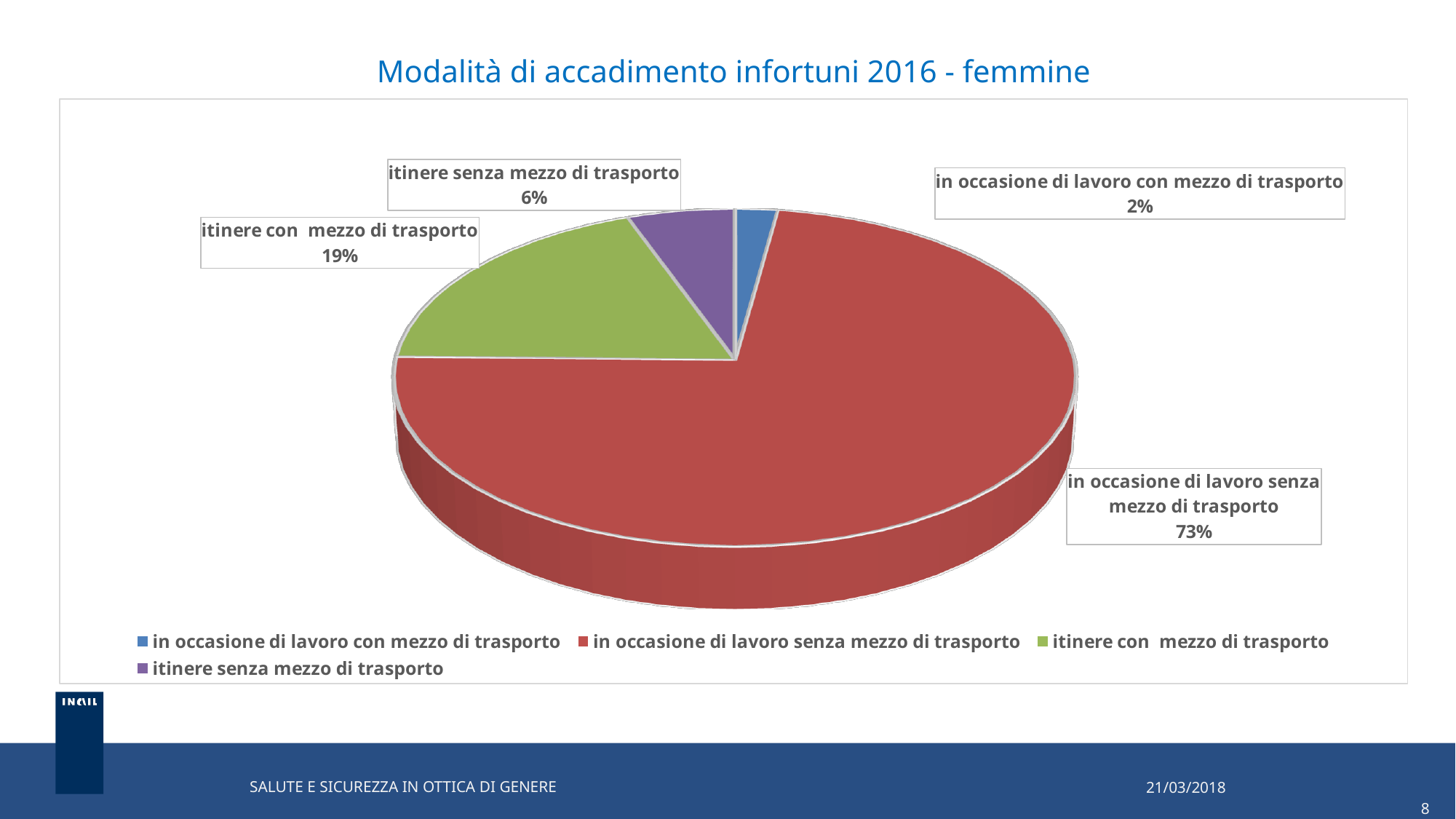
What is the value shown for 'itinere senza mezzo di trasporto'? 6% How many categories are shown in the pie chart? 4 What is the title of the chart? Modalità di accadimento infortuni 2016 - femmine Which category has the smallest slice of the pie? in occasione di lavoro con mezzo di trasporto Which is larger: 'itinere con mezzo di trasporto' or 'itinere senza mezzo di trasporto'? itinere con mezzo di trasporto Which category has the largest slice of the pie? in occasione di lavoro senza mezzo di trasporto What kind of chart is shown on the slide? pie chart What share of the pie does 'itinere con mezzo di trasporto' represent? 19% What is the difference in percentage points between 'in occasione di lavoro senza mezzo di trasporto' and 'itinere con mezzo di trasporto'? 54 What colour is the slice for 'itinere con mezzo di trasporto'? green What share of the pie does 'in occasione di lavoro senza mezzo di trasporto' represent? 73% What is the value shown for 'in occasione di lavoro con mezzo di trasporto'? 2%